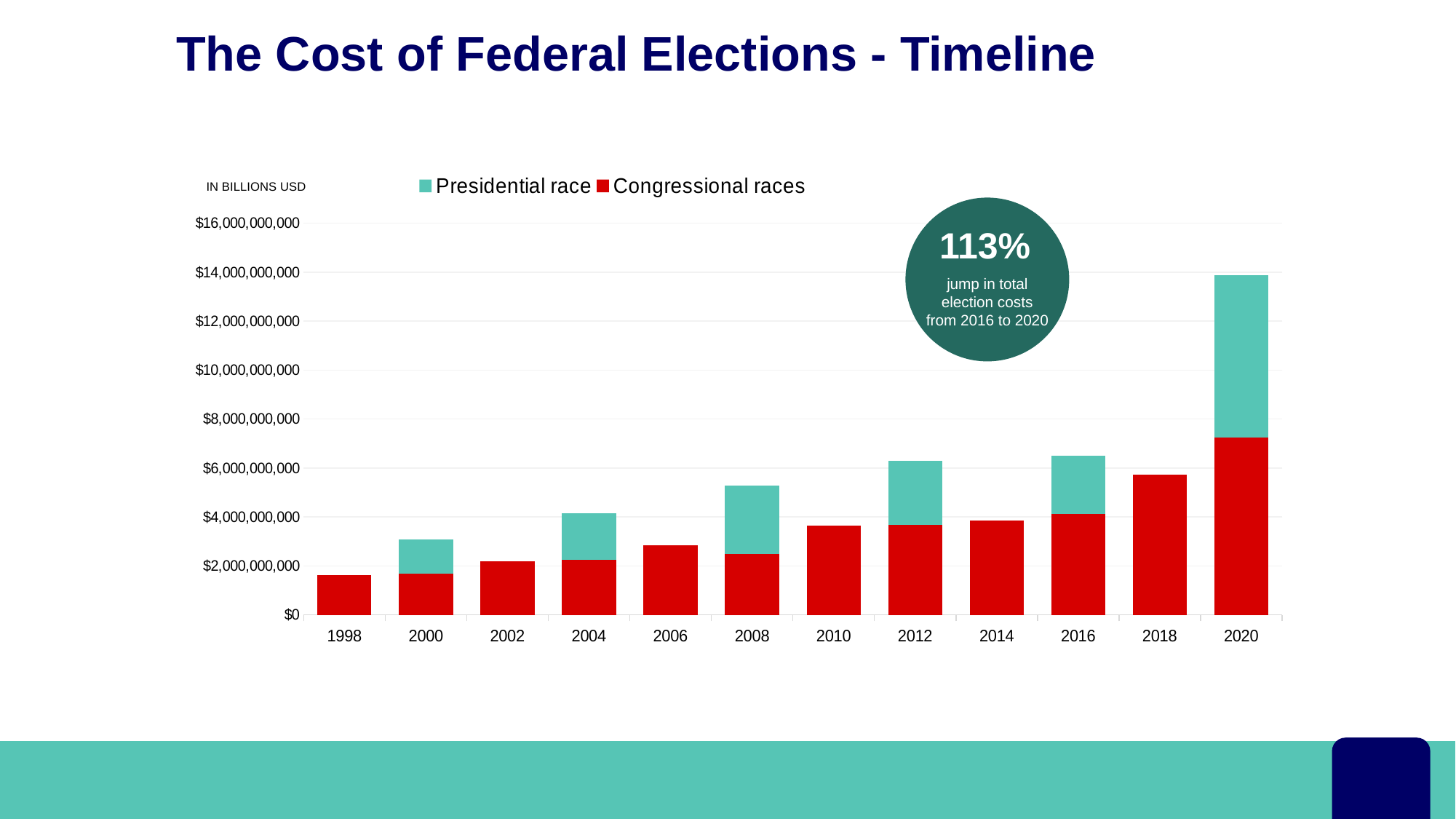
How many series does the chart legend list? 2 How many election years are shown on the x axis of the chart? 12 What kind of chart is shown on the slide? Stacked bar chart Which year has the lowest total election cost in the chart? 1998 Which year has the highest total election cost in the chart? 2020 Is the Congressional races value for 2018 greater or less than $6,000,000,000? less Is the total election cost for 2020 greater or less than $12,000,000,000? greater Do total election costs generally rise or fall from 1998 to 2020 in the chart? Rise Which year has the larger total election cost, 2016 or 2020? 2020 Is the Congressional races value for 2006 greater or less than $2,000,000,000? greater According to the callout on the chart, by what percentage did total election costs jump from 2016 to 2020? 113%